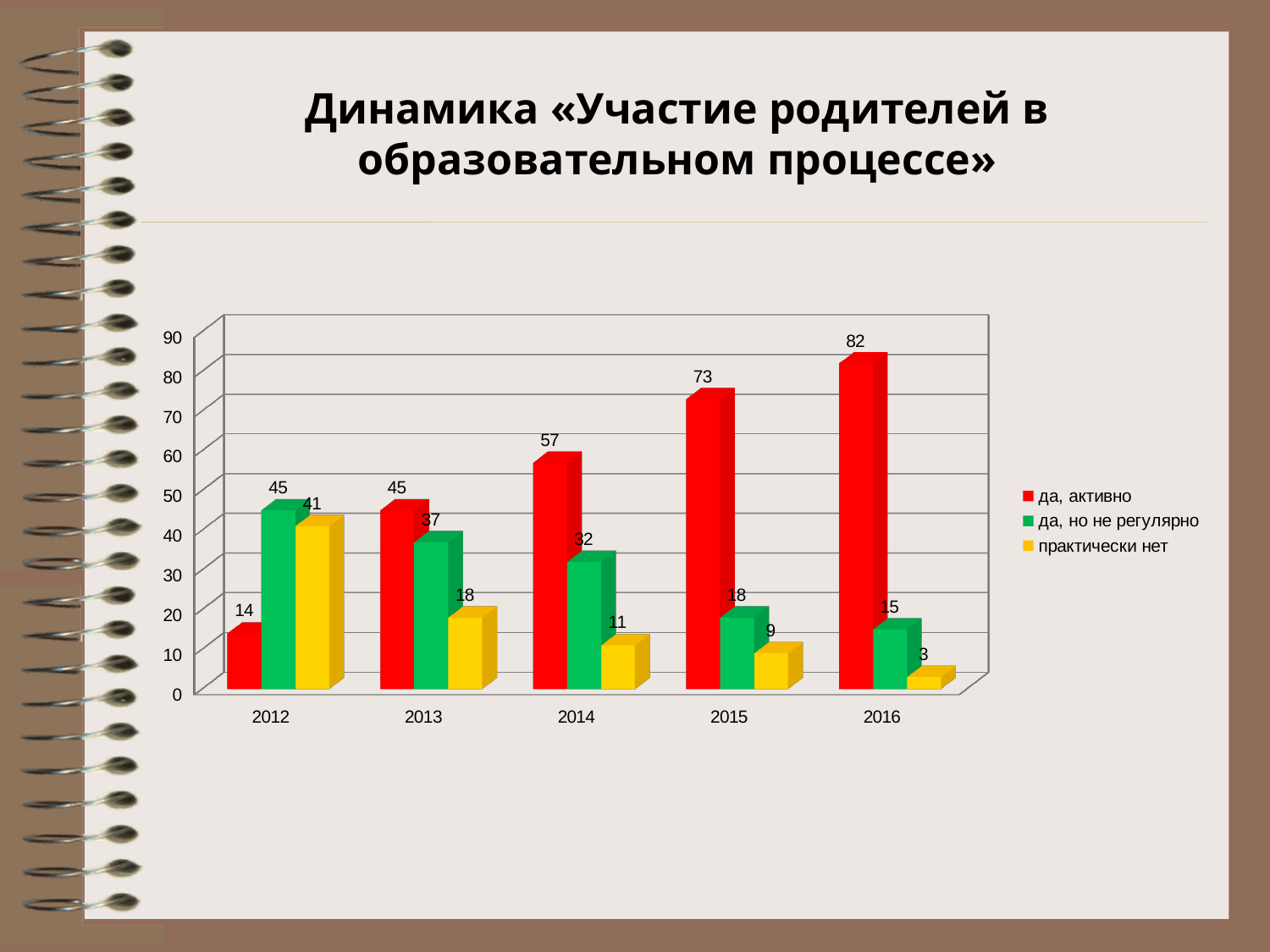
What kind of chart is shown on the slide? bar chart Which is larger in 2013: «да, активно» or «да, но не регулярно»? да, активно What is the value for «да, но не регулярно» in 2014? 32 In which year is the value for «да, активно» the highest? 2016 Do the values for «да, активно» rise or fall from 2012 to 2016? rise In which year is the value for «практически нет» the lowest? 2016 How many series does the legend list? 3 What colour represents «практически нет» in the legend? yellow What is the value for «да, активно» in 2016? 82 How many years are shown on the x axis? 5 What is the difference between the «да, активно» values for 2016 and 2012? 68 What is the value for «практически нет» in 2012? 41